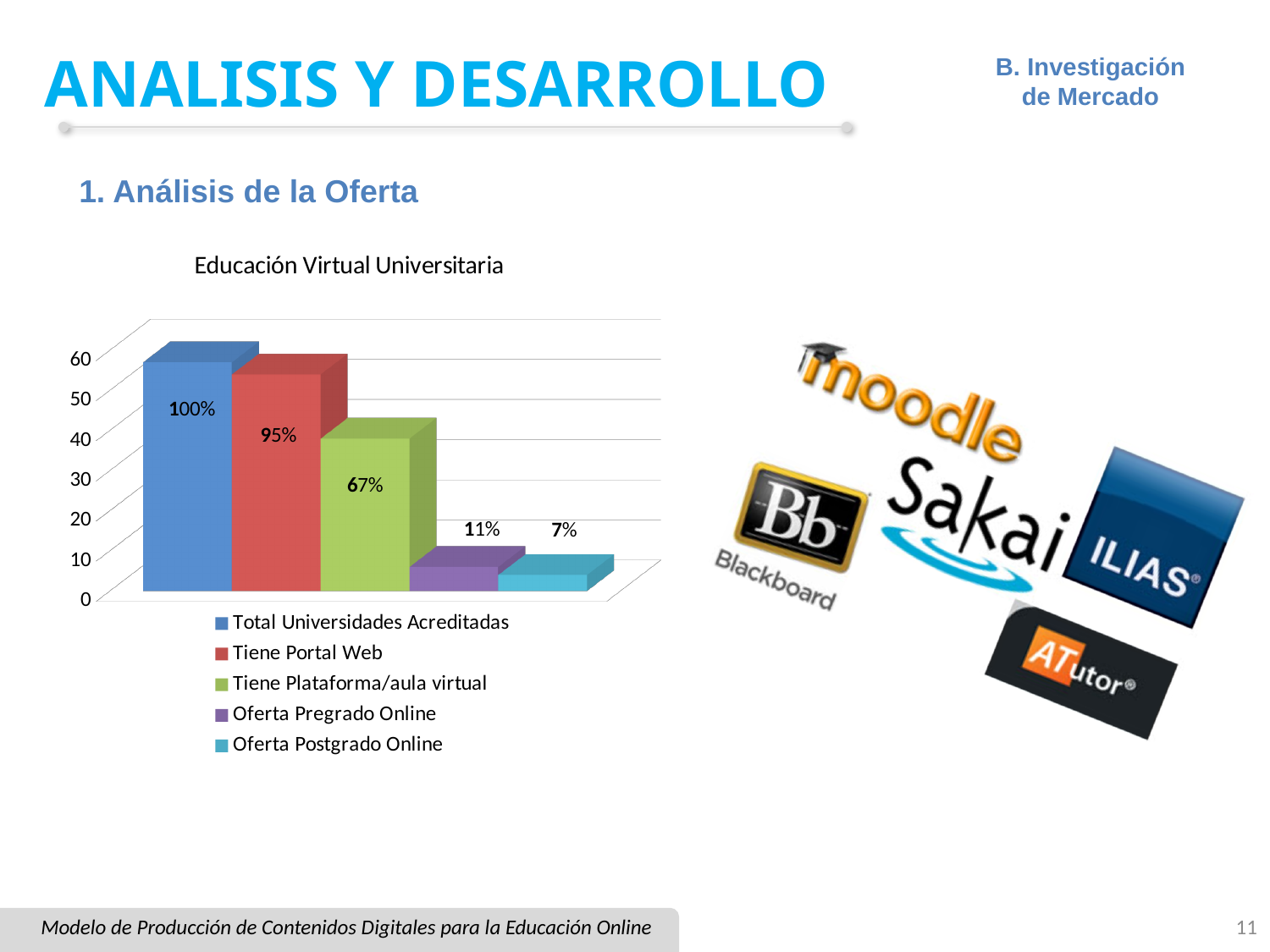
Which series has the lowest value in the chart? Oferta Postgrado Online What is the title of the chart on the slide? Educación Virtual Universitaria By how many percentage points does 'Tiene Portal Web' exceed 'Tiene Plataforma/aula virtual'? 28 What is the data label shown on the bar for 'Tiene Portal Web'? 95% How many bars are plotted in the chart? 5 Do the bar values rise or fall from left to right across the chart? fall What is the data label shown on the bar for 'Oferta Postgrado Online'? 7% What kind of chart is shown under the title 'Educación Virtual Universitaria'? bar chart What is the data label shown on the bar for 'Total Universidades Acreditadas'? 100% Which series has the highest value in the chart? Total Universidades Acreditadas What is the data label shown on the bar for 'Tiene Plataforma/aula virtual'? 67% How many series does the chart legend list? 5